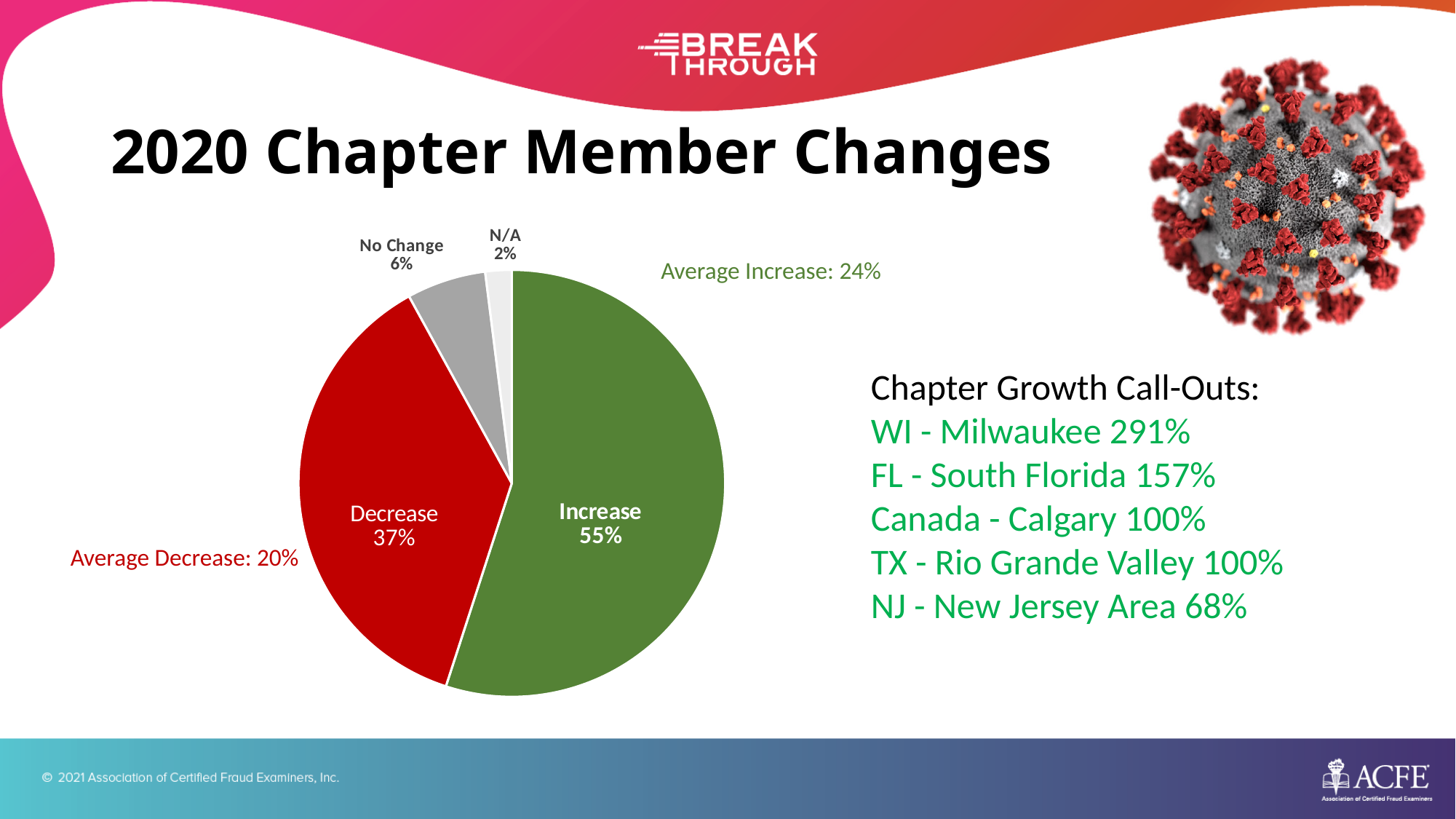
What is the value shown for the No Change slice? 6% Which is larger, the Decrease slice or the No Change slice? Decrease What is the difference between the Increase and Decrease slices? 18% How many slices does the pie chart have? 4 Which slice of the pie is the largest? Increase What is the title of the slide containing the pie chart? 2020 Chapter Member Changes Which slice of the pie is the smallest? N/A What share of the pie does the Increase slice represent? 55% What colour is the Decrease slice? red What kind of chart is shown on the slide? pie chart What is the value shown for the Decrease slice? 37% What is the value shown for the N/A slice? 2%